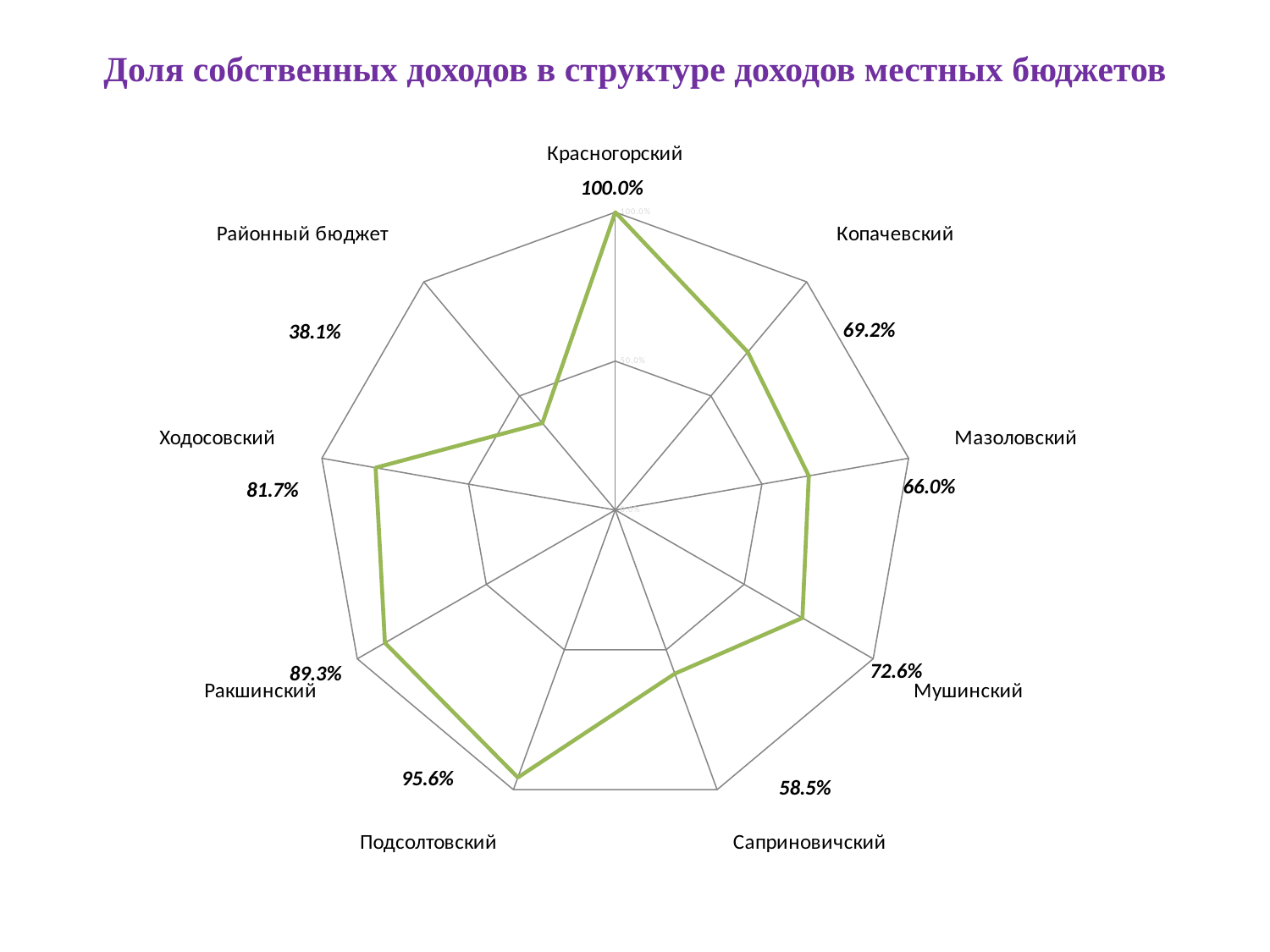
Which category has the lowest value? Районный бюджет Which category has the highest value? Красногорский What is the value for Саприновичский? 58.5% What is the value for Районный бюджет? 38.1% What is the value for Подсолтовский? 95.6% What is the title of the chart on the slide? Доля собственных доходов в структуре доходов местных бюджетов Which is larger, the value for Мушинский or the value for Саприновичский? Мушинский Which is larger, the value for Копачевский or the value for Мазоловский? Копачевский What is the value for Красногорский? 100.0% What is the difference between the values for Ракшинский and Ходосовский? 7.6% What kind of chart is shown on the slide? Radar chart How many categories are plotted on the chart? 9